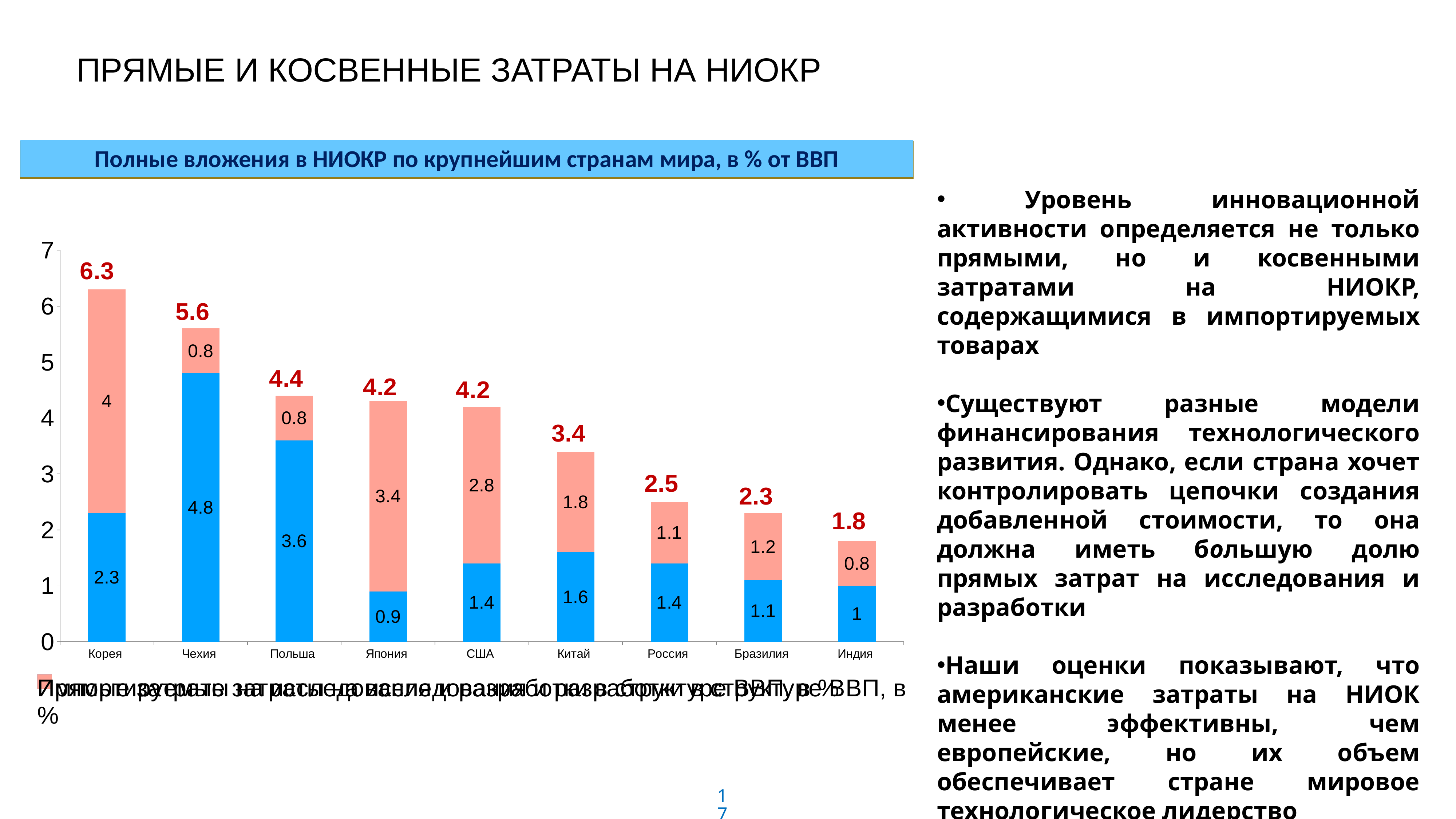
Which country has the highest total bar? Корея Which is larger: the blue segment for Польша or the blue segment for США? Польша What is the title shown in the blue banner above the chart? Полные вложения в НИОКР по крупнейшим странам мира, в % от ВВП What is the value of the blue (bottom) segment for Чехия? 4.8 What is the value of the pink (top) segment for Япония? 3.4 What is the total value shown above the bar for Корея? 6.3 Is the total for Китай greater or less than 3? greater Do the total values rise or fall moving from Корея to Индия along the x axis? Fall Which country has the lowest total bar? Индия What is the difference between the total for Корея and the total for Чехия? 0.7 What kind of chart is shown on the slide? Stacked bar chart How many countries are shown on the x axis? 9